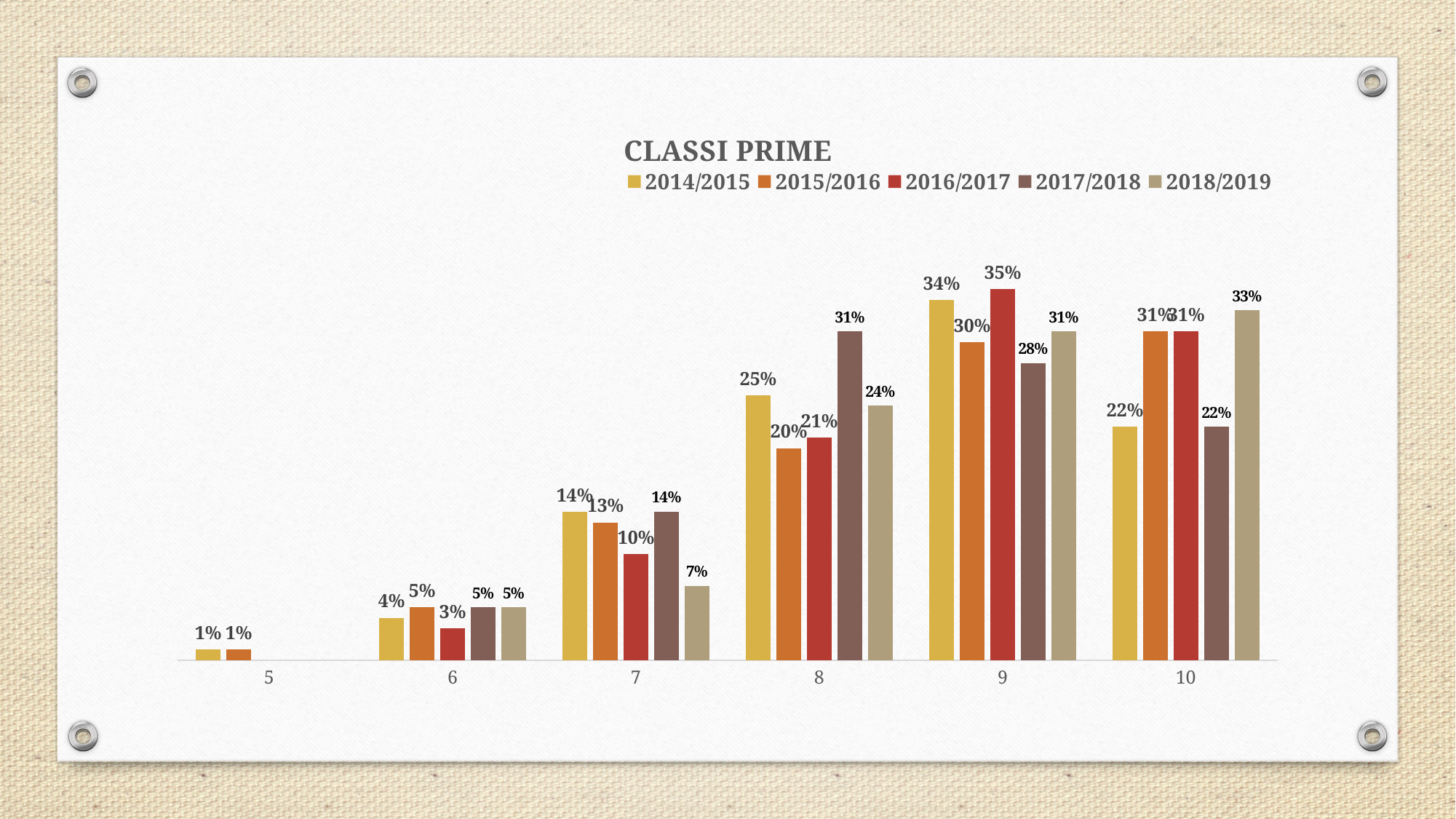
Which category has the highest value in the 2014/2015 series? 9 What is the value for category 8 in the 2017/2018 series? 31% How many categories are shown on the x axis? 6 For category 7, which is larger: the 2016/2017 value or the 2018/2019 value? 2016/2017 What is the title of the chart? CLASSI PRIME What kind of chart is shown on the slide? Bar chart Do the 2015/2016 values rise or fall from category 5 to category 10? Rise How many series does the legend list? 5 What is the difference between the 2014/2015 and 2015/2016 values for category 8? 5% Which category has the lowest value in the 2018/2019 series? 6 What is the value for category 10 in the 2018/2019 series? 33% What is the value for category 9 in the 2016/2017 series? 35%